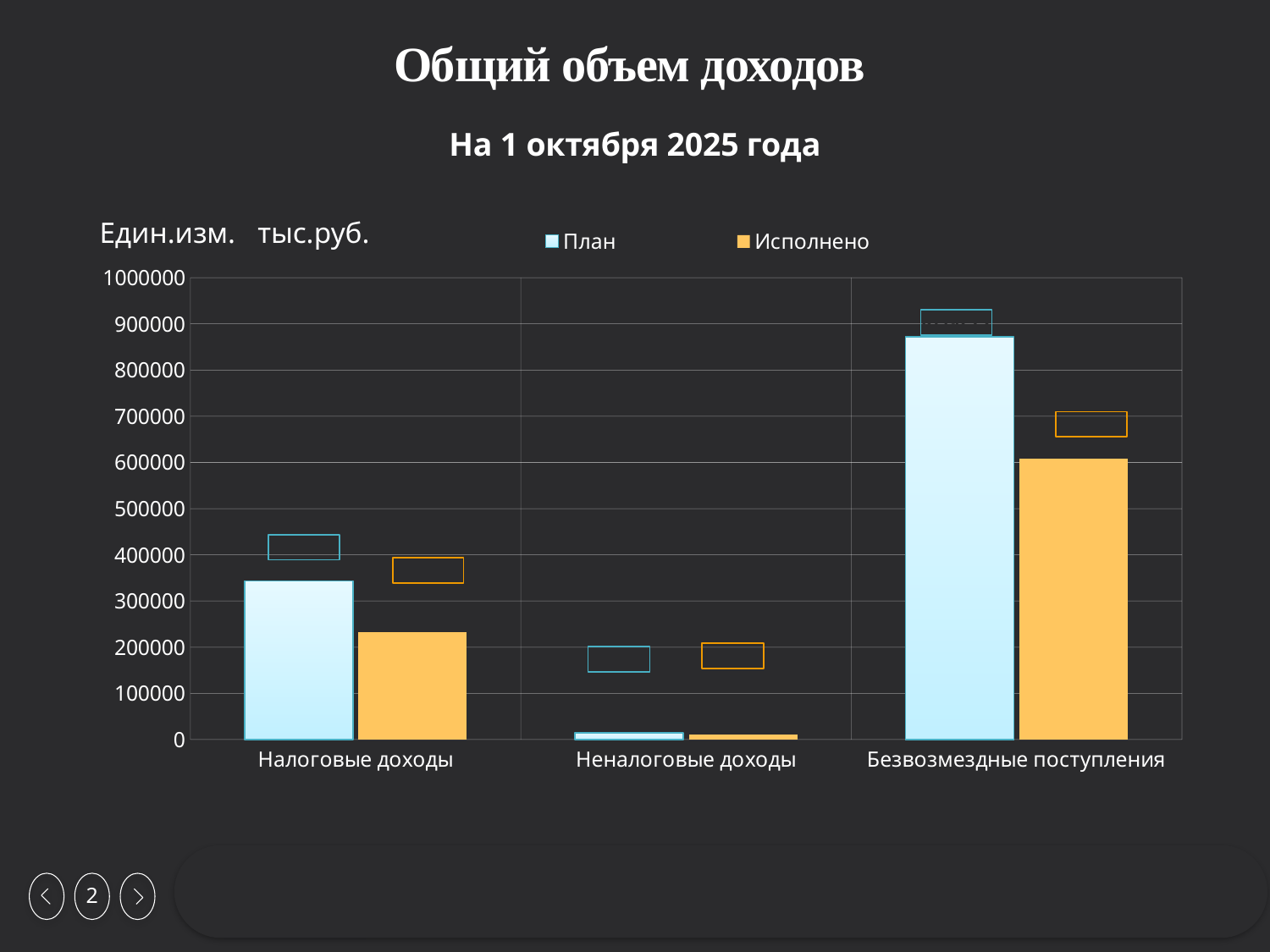
Is the План value for Налоговые доходы greater or less than 300000? greater Is the План value for Безвозмездные поступления greater or less than 800000? greater Is the План value for Неналоговые доходы greater or less than 100000? less What unit of measurement is stated for the chart? тыс.руб. What kind of chart is shown on the slide? bar chart For Безвозмездные поступления, which is larger: План or Исполнено? План How many categories are shown on the x axis? 3 Which category has the highest План value? Безвозмездные поступления Which category has the lowest Исполнено value? Неналоговые доходы How many series does the legend list? 2